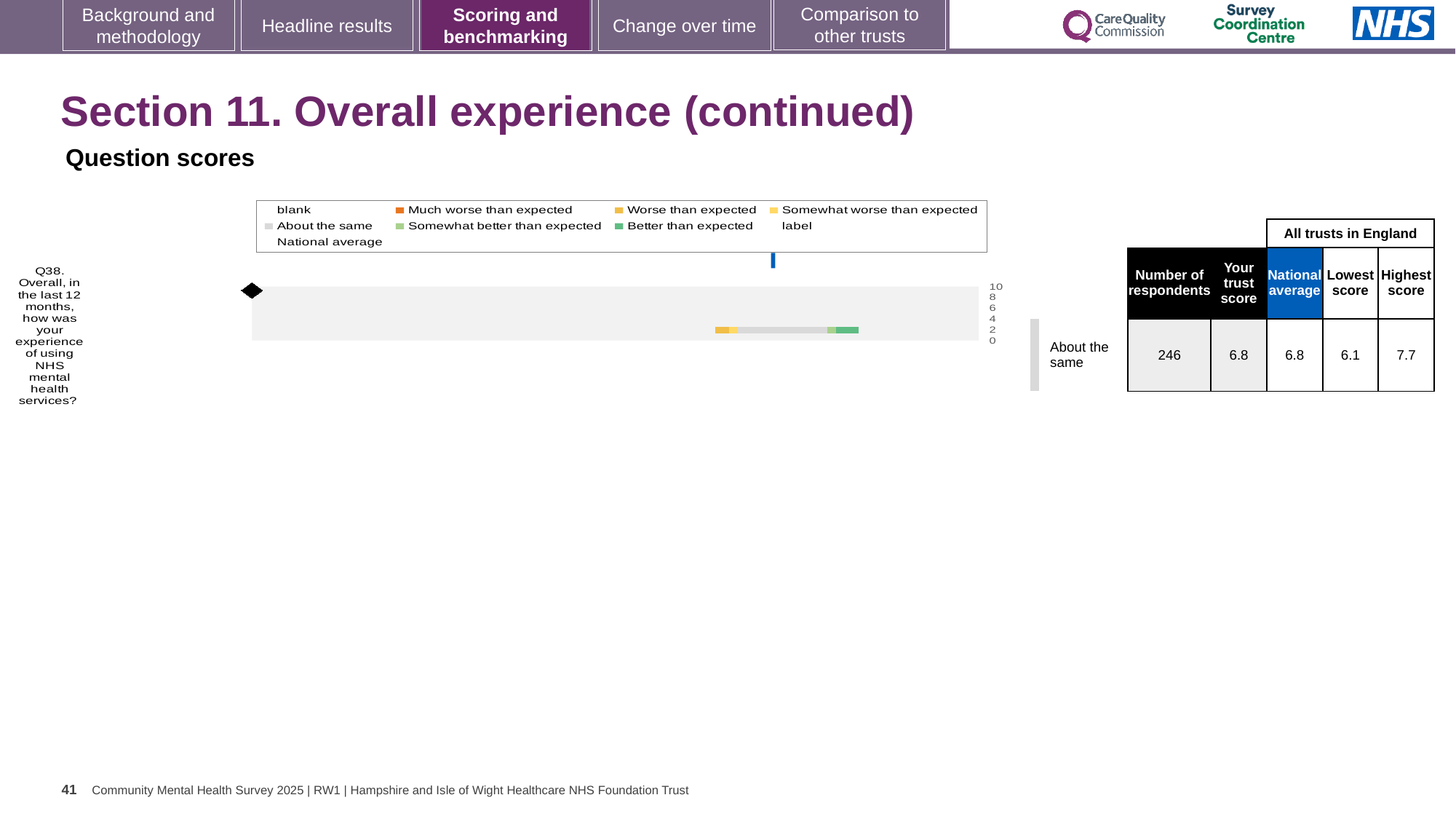
Which legend entry is shown in dark green? Better than expected What is the highest score among all trusts in England for Q38? 7.7 How many questions are plotted on the chart? 1 What is the trust score for Q38 shown in the table? 6.8 How many respondents answered Q38? 246 Which is larger for Q38: the highest score in England or the trust score? Highest score What benchmark category is Q38 assigned to? About the same What is the difference between the highest and lowest trust scores for Q38? 1.6 Is the trust score for Q38 larger than, smaller than, or equal to the national average? equal What kind of chart is used to show the question score? Bar chart What is the national average score for Q38? 6.8 What is the lowest score among all trusts in England for Q38? 6.1